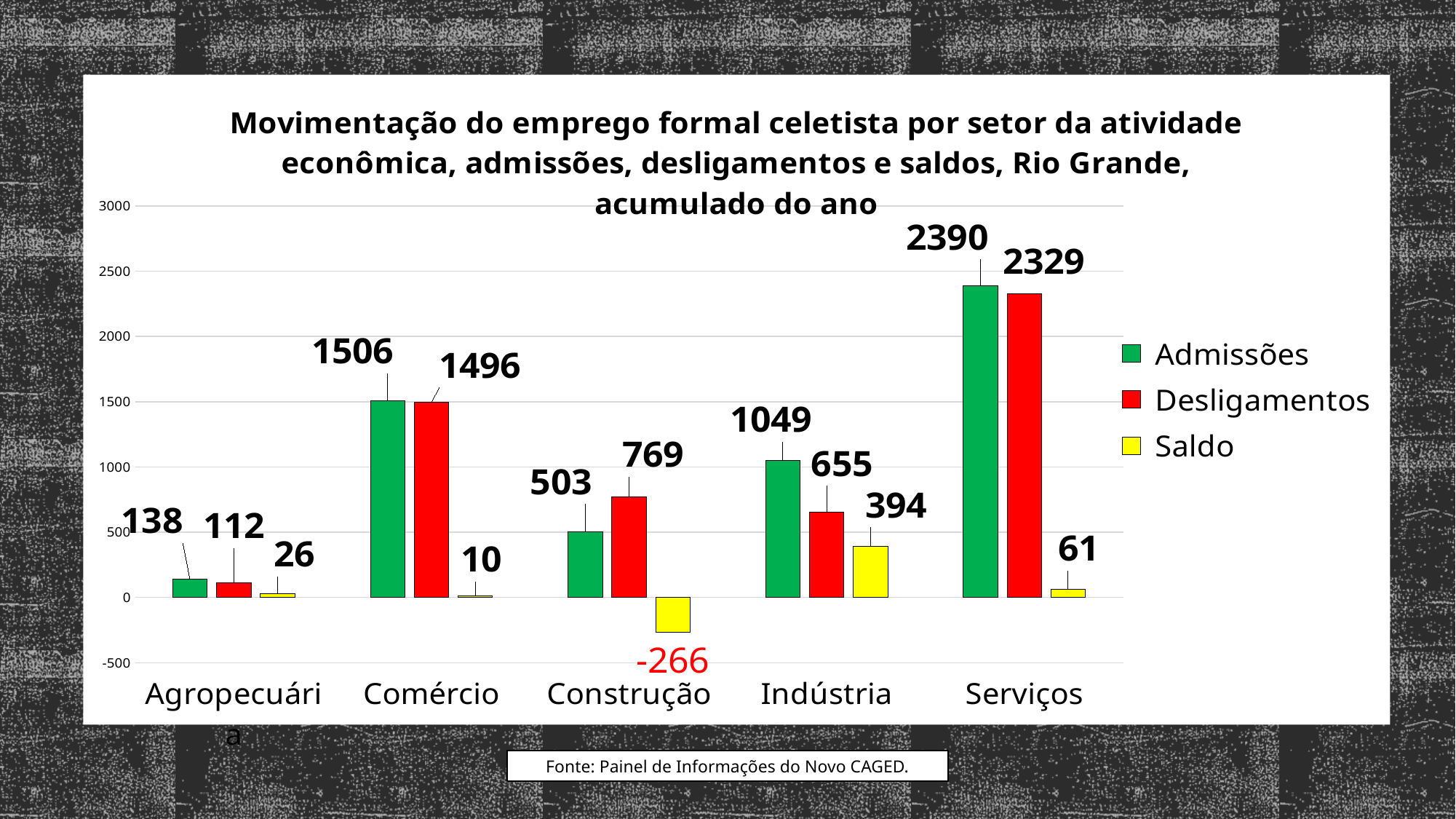
What kind of chart is shown on the slide? Bar chart What is the difference between Admissões and Desligamentos for Indústria? 394 Which colour represents the Saldo series in the legend? Yellow Which sector has the highest Admissões value? Serviços What is the Saldo value for Construção? -266 Which sector has the lowest Desligamentos value? Agropecuária How many sectors are shown on the x axis? 5 Which is larger for Construção, Admissões or Desligamentos? Desligamentos What is the Saldo value for Indústria? 394 What is the value of Admissões for Serviços? 2390 What is the value of Desligamentos for Construção? 769 How many series does the legend list? 3